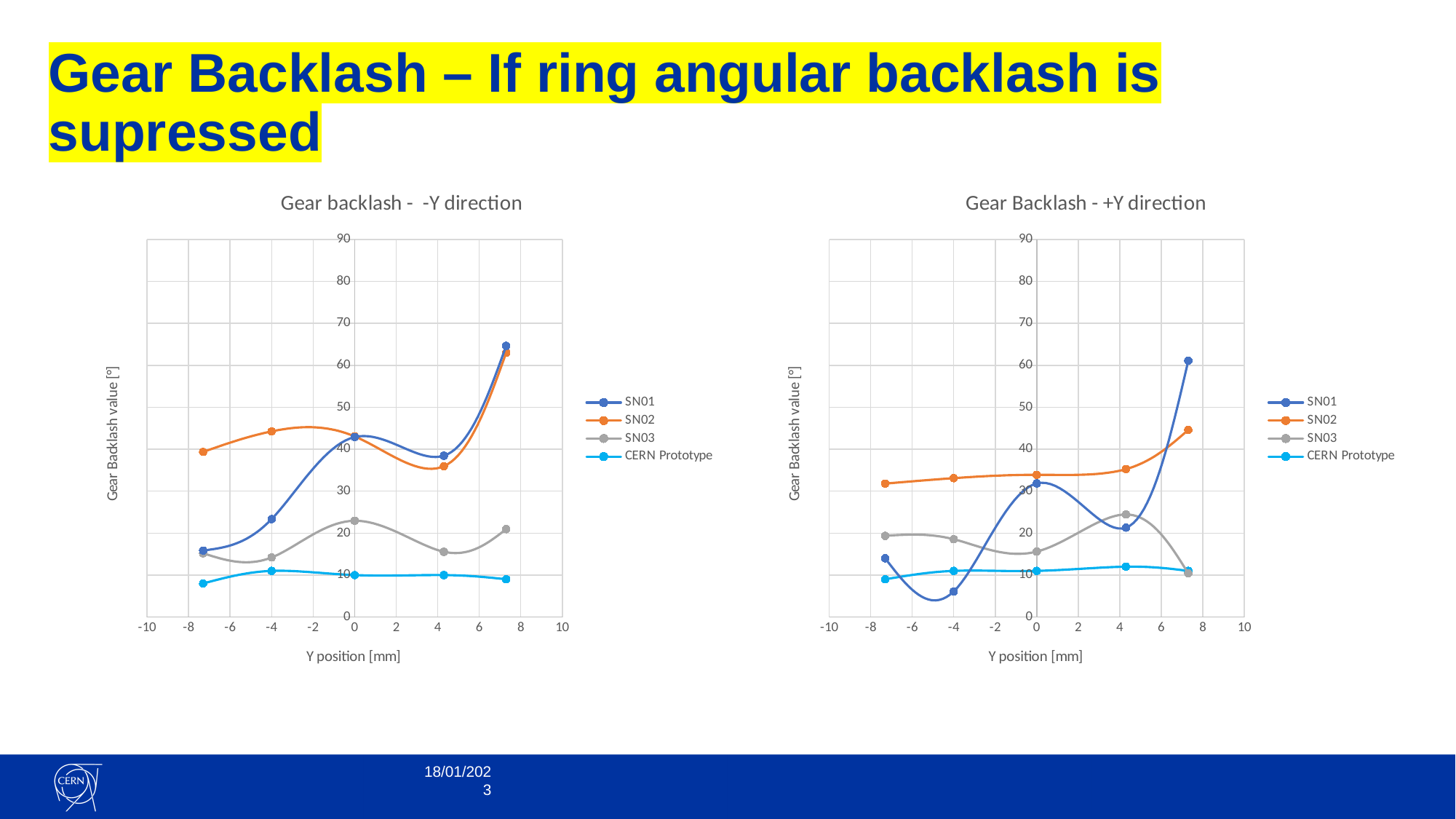
In the 'Gear Backlash - +Y direction' chart, is the SN02 value at Y position 0 greater or less than 30? greater What is the x-axis title of the 'Gear Backlash - +Y direction' chart? Y position [mm] In the 'Gear backlash - -Y direction' chart, which series has the highest value at the leftmost Y position (around -8 mm)? SN02 In the 'Gear backlash - -Y direction' chart, is the SN03 value at Y position 0 greater or less than 20? greater In the 'Gear Backlash - +Y direction' chart, which series has the highest value at the rightmost Y position (around 7 mm)? SN01 In the 'Gear Backlash - +Y direction' chart, which series has the lowest value at Y position -4? SN01 What kind of chart is the 'Gear backlash - -Y direction' chart? line chart In the 'Gear backlash - -Y direction' chart, how many data points are plotted for the SN01 series? 5 How many series does the legend of the 'Gear Backlash - +Y direction' chart list? 4 In the 'Gear backlash - -Y direction' chart, at Y position 0, which is larger: SN03 or CERN Prototype? SN03 In the 'Gear backlash - -Y direction' chart, is the SN01 value at the rightmost Y position (around 7 mm) greater or less than 60? greater In the 'Gear Backlash - +Y direction' chart, does the SN02 series rise or fall as Y position increases? rise